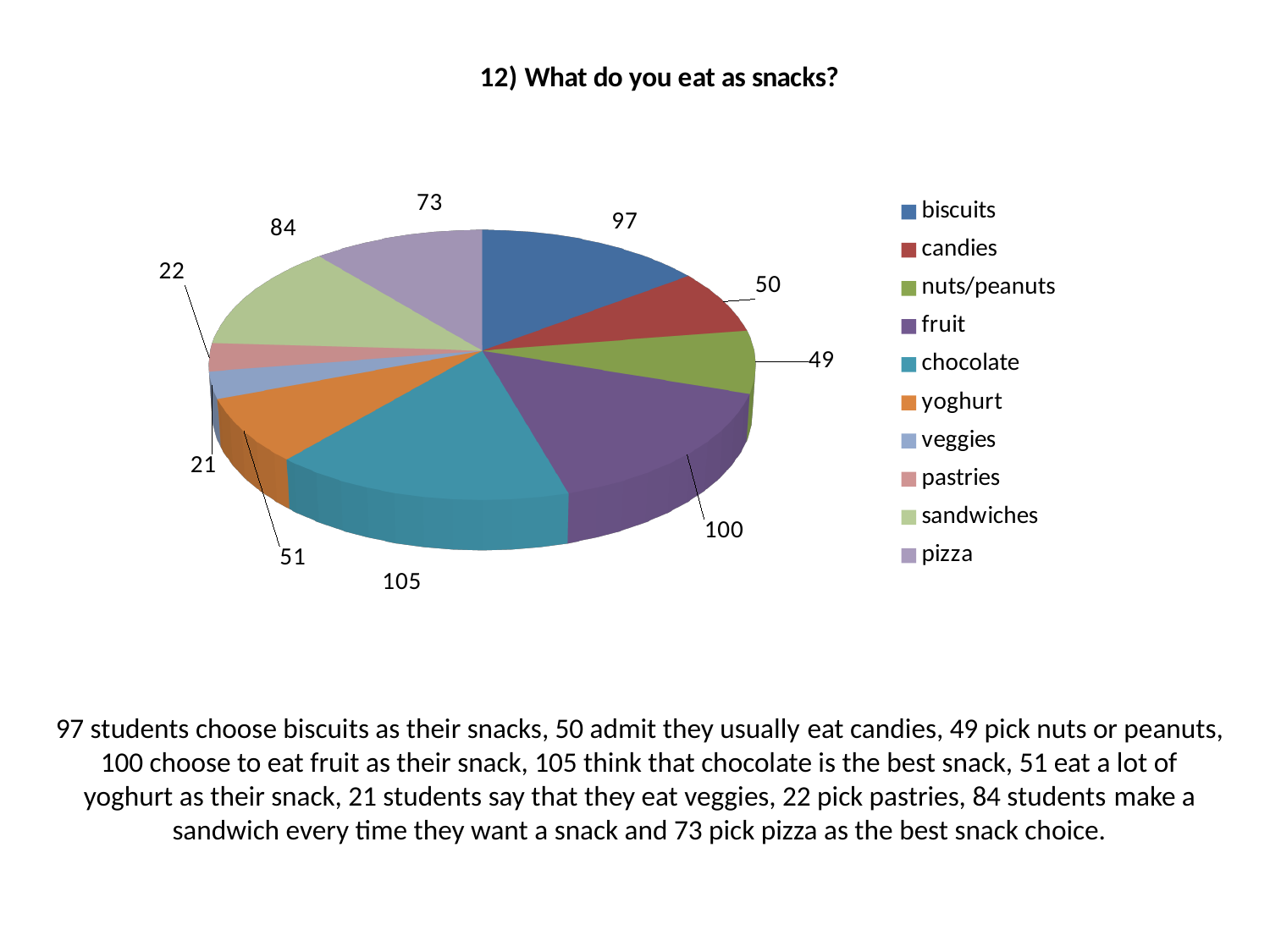
Which snack category has the largest slice? chocolate What is the value for sandwiches? 84 What is the value for veggies? 21 How many students chose chocolate as a snack? 105 What is the total of all the values in the pie chart? 652 What is the difference between the values for fruit and biscuits? 3 What is the difference between the values for sandwiches and pizza? 11 What type of chart is shown on the slide? pie chart Which is larger, the value for candies or the value for yoghurt? yoghurt How many categories does the pie chart have? 10 What is the title of the chart? 12) What do you eat as snacks? Which snack category has the smallest slice? veggies